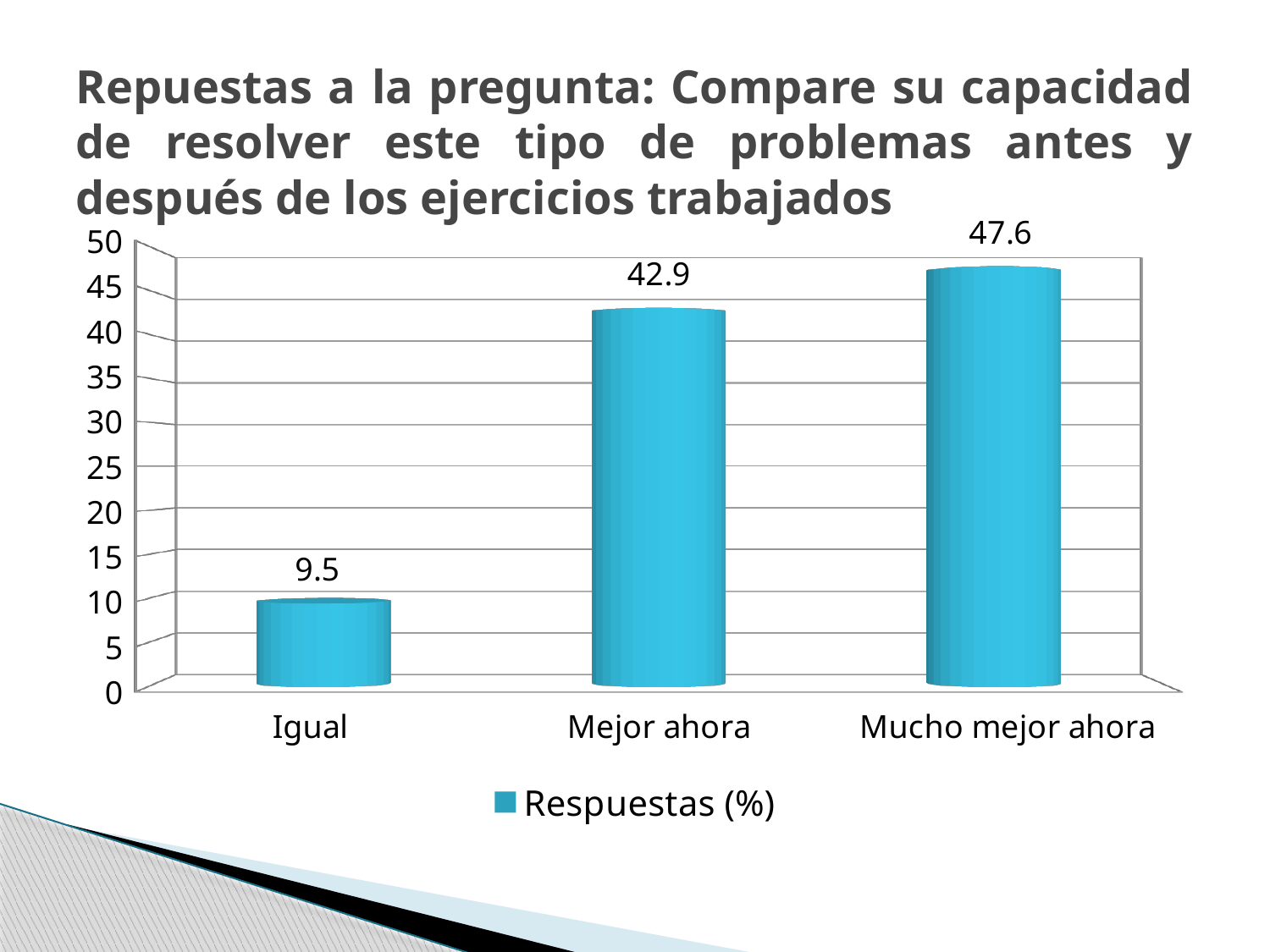
Is the value for "Mejor ahora" greater or less than 40? greater What is the difference between the values for "Mucho mejor ahora" and "Mejor ahora"? 4.7 What is the difference between the values for "Mejor ahora" and "Igual"? 33.4 Which category has the highest value? Mucho mejor ahora What kind of chart is shown on the slide? Bar chart What is the value for "Mucho mejor ahora"? 47.6 What is the value for "Mejor ahora"? 42.9 How many categories are shown on the x axis? 3 Which category has the lowest value? Igual Which is larger, the value for "Igual" or the value for "Mejor ahora"? Mejor ahora What series name does the legend show? Respuestas (%) What is the value for "Igual"? 9.5